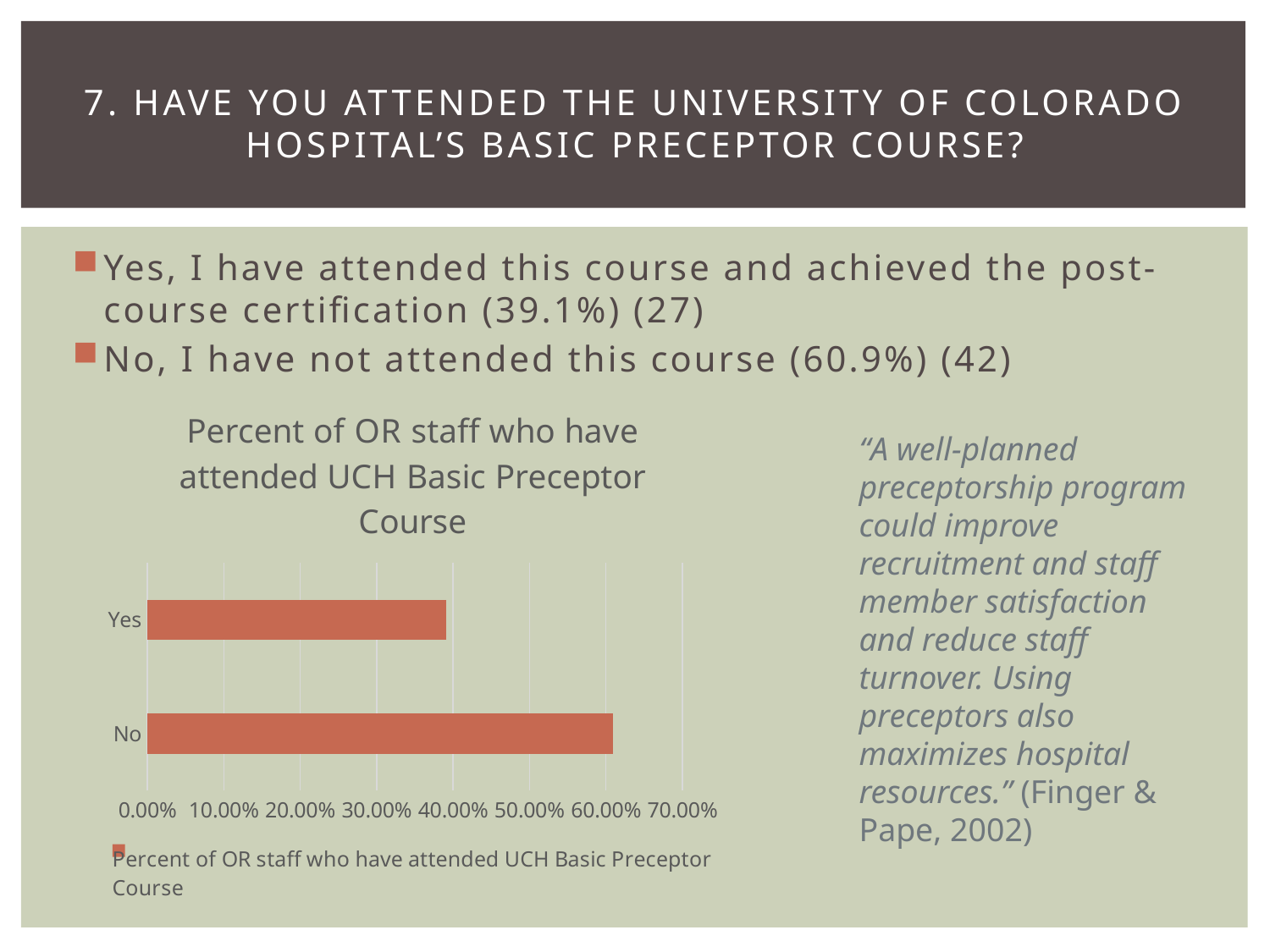
What is the title of the chart? Percent of OR staff who have attended UCH Basic Preceptor Course Is the value for No greater or less than 70.00%? less What kind of chart is shown on the slide? bar chart What is the highest value shown on the chart's x axis? 70.00% Which is larger, the value for Yes or the value for No? No How many categories does the chart show? 2 Is the value for No greater or less than 60.00%? greater Which category has the lowest value in the chart? Yes Is the value for Yes greater or less than 30.00%? greater How many series does the chart legend list? 1 Which category has the highest value in the chart? No